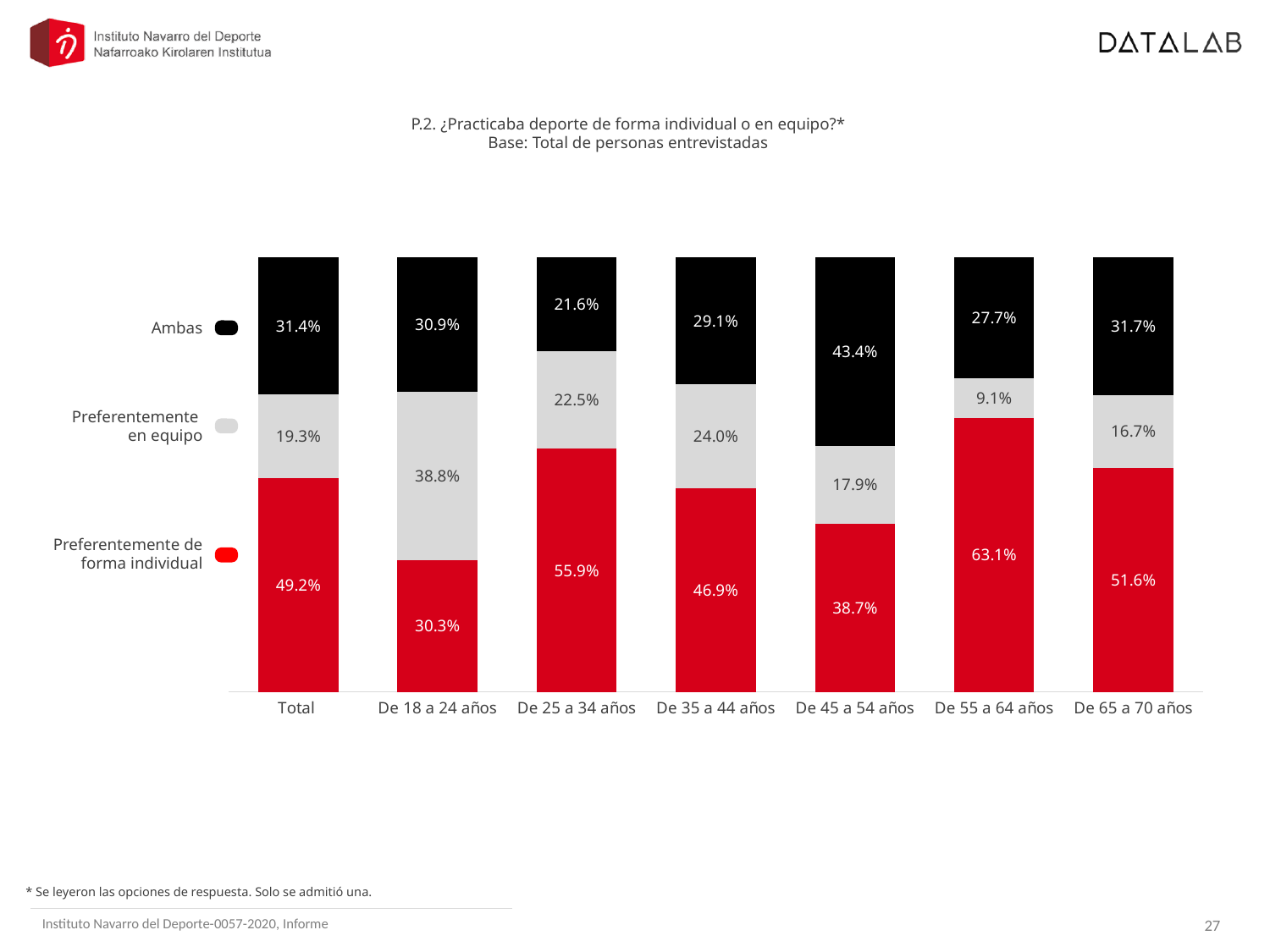
What type of chart is shown on the slide? Stacked bar chart What is the value of 'Ambas' for 'De 45 a 54 años'? 43.4% How many series does the legend list? 3 What is the value of 'Preferentemente en equipo' for 'De 55 a 64 años'? 9.1% How many categories are shown along the x axis? 7 Which is larger: the 'Ambas' value for 'De 35 a 44 años' or for 'De 25 a 34 años'? De 35 a 44 años Which category has the highest value for 'Preferentemente en equipo'? De 18 a 24 años Which age category has the highest value for 'Preferentemente de forma individual'? De 55 a 64 años Which category has the lowest value for 'Preferentemente en equipo'? De 55 a 64 años What colour represents 'Preferentemente de forma individual' in the chart? Red What is the value of 'Preferentemente de forma individual' for the Total category? 49.2% What is the difference between the 'Preferentemente de forma individual' values for 'De 55 a 64 años' and 'De 18 a 24 años'? 32.8 percentage points